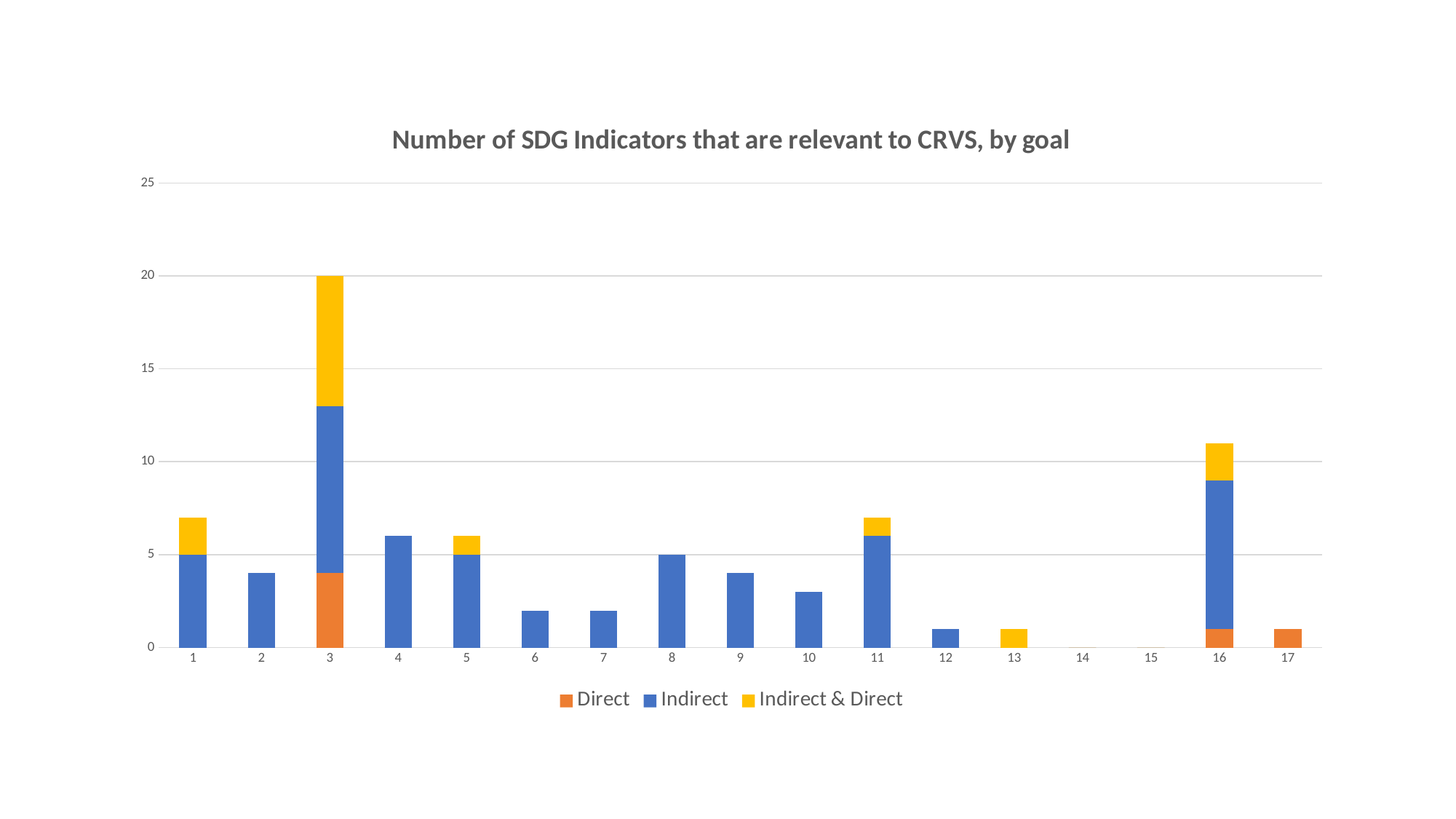
Which colour represents the Direct series in the legend? Orange What is the number of indicators for goal 8? 5 Is the value for goal 4 greater or less than 5? greater What is the total number of indicators for goal 3? 20 How many goals are shown along the x axis? 17 Is the value for goal 12 greater or less than 5? less Which has a larger total, goal 2 or goal 4? Goal 4 What is the title of the chart? Number of SDG Indicators that are relevant to CRVS, by goal What kind of chart is shown on the slide? Stacked bar chart How many series does the legend list? 3 Is the total value for goal 16 greater or less than 10? greater Which goal has the highest total number of indicators? 3